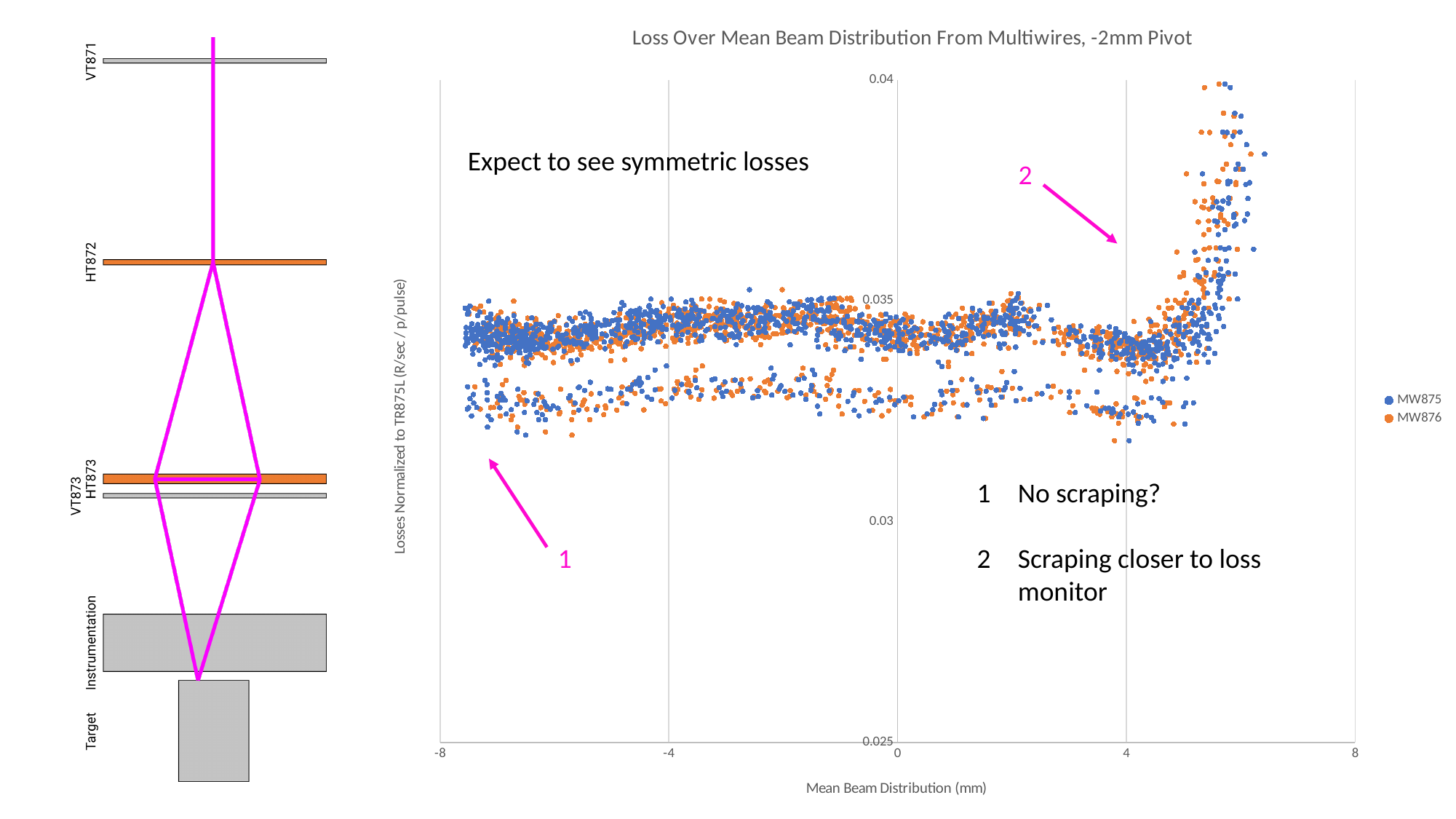
What is the lowest value shown on the y axis of the chart? 0.025 What kind of chart is shown on the slide? scatter chart Which region of the chart has the higher loss values: near a mean beam distribution of 6 mm or near -6 mm? near 6 mm What is the label of the x axis of the chart? Mean Beam Distribution (mm) Are the loss values of the lower band of points near a mean beam distribution of -6 mm greater or less than 0.035? less Are the loss values for points near a mean beam distribution of 6 mm greater or less than 0.035? greater How many series does the legend of the chart list? 2 Which series in the chart is plotted in orange? MW876 Do the loss values rise or fall as the mean beam distribution increases beyond 4 mm? rise What is the title of the chart? Loss Over Mean Beam Distribution From Multiwires, -2mm Pivot What is the highest value shown on the y axis of the chart? 0.04 Are the loss values for points near a mean beam distribution of 0 mm greater or less than 0.03? greater